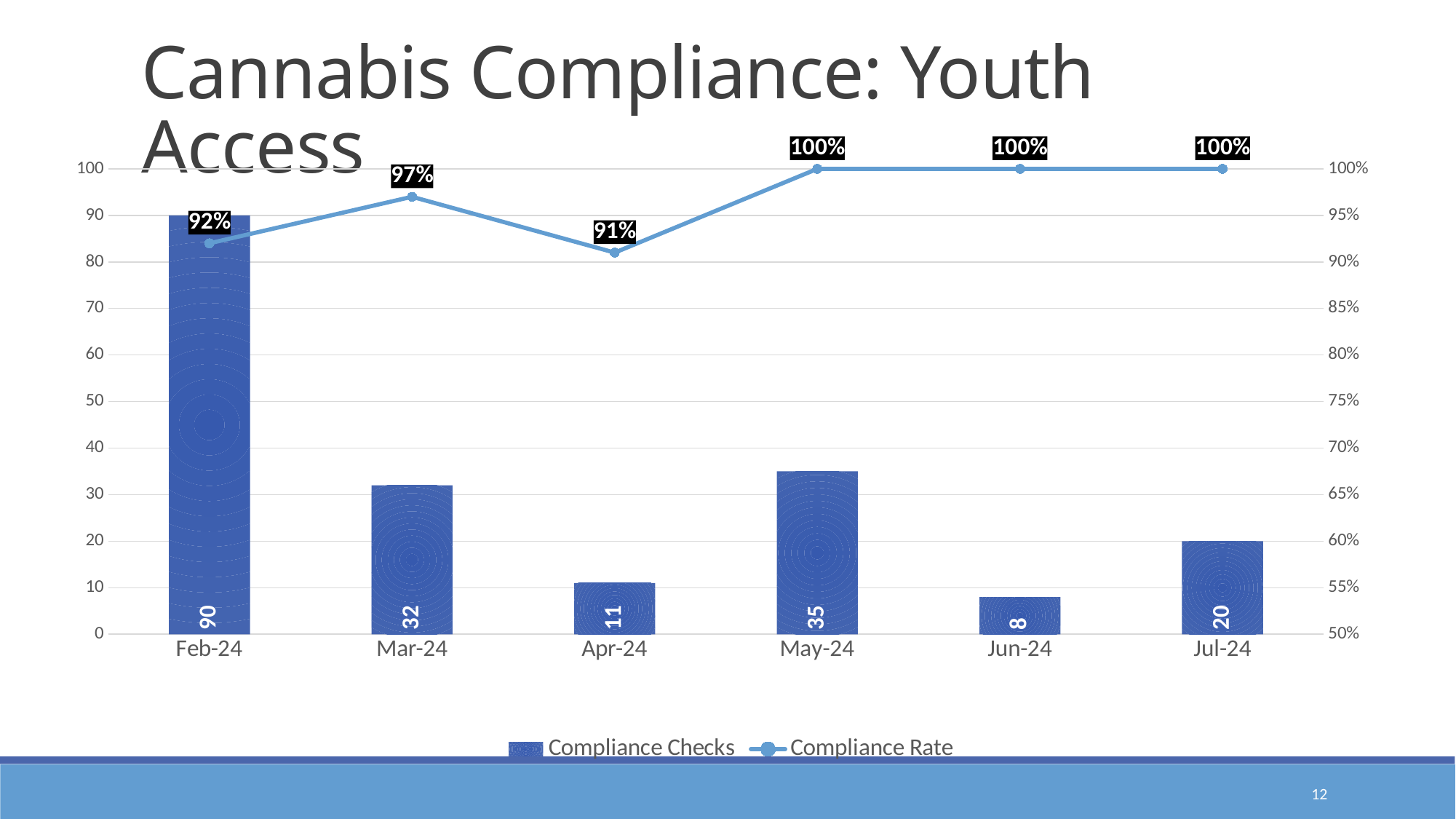
How many months are shown on the x axis? 6 What is the total number of Compliance Checks across all six months? 196 How many Compliance Checks were conducted in Jun-24? 8 What is the title of the slide? Cannabis Compliance: Youth Access How many Compliance Checks were conducted in Feb-24? 90 Which month had the highest number of Compliance Checks? Feb-24 Which month had more Compliance Checks, May-24 or Jul-24? May-24 What was the Compliance Rate in Apr-24? 91% What is the difference in Compliance Checks between Feb-24 and Mar-24? 58 Which month had the lowest Compliance Rate? Apr-24 How many series does the legend list? 2 What kinds of chart are combined on this slide? Bar chart and line chart